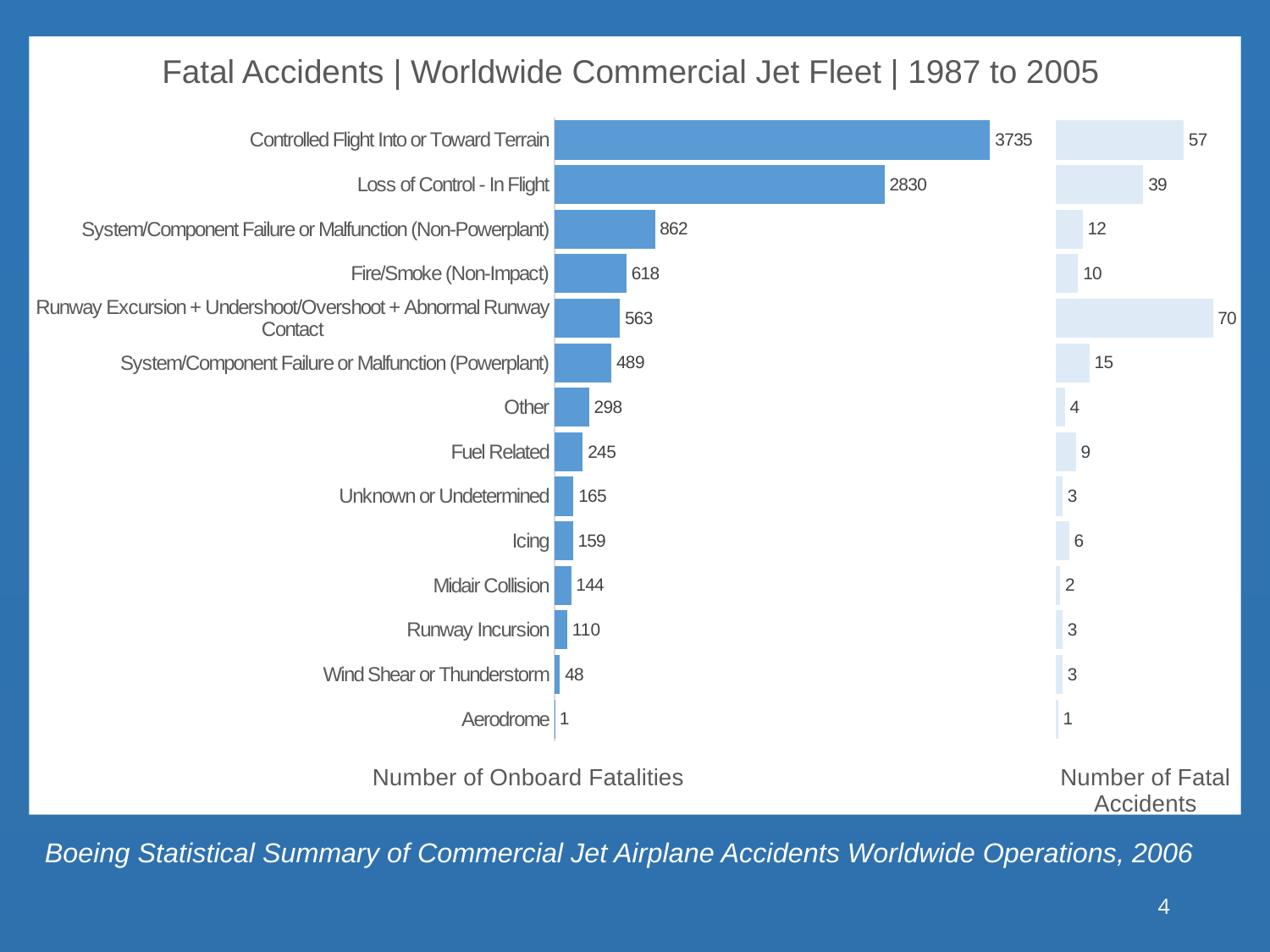
In the Number of Fatal Accidents chart, what is the difference between Controlled Flight Into or Toward Terrain and Loss of Control - In Flight? 18 How many categories are shown in the Number of Onboard Fatalities chart? 14 What type of chart is used for Number of Onboard Fatalities? Bar chart In the Number of Onboard Fatalities chart, which category has the highest value? Controlled Flight Into or Toward Terrain What is the title of the slide containing the charts? Fatal Accidents | Worldwide Commercial Jet Fleet | 1987 to 2005 In the Number of Fatal Accidents chart, which category has the highest value? Runway Excursion + Undershoot/Overshoot + Abnormal Runway Contact In the Number of Onboard Fatalities chart, which category has the lowest value? Aerodrome In the Number of Fatal Accidents chart, which is larger: Fuel Related or Icing? Fuel Related In the Number of Fatal Accidents chart, what is the value for Runway Excursion + Undershoot/Overshoot + Abnormal Runway Contact? 70 In the Number of Onboard Fatalities chart, what is the difference between Controlled Flight Into or Toward Terrain and Loss of Control - In Flight? 905 In the Number of Onboard Fatalities chart, which is larger: Fire/Smoke (Non-Impact) or System/Component Failure or Malfunction (Powerplant)? Fire/Smoke (Non-Impact) In the Number of Onboard Fatalities chart, what is the value for Loss of Control - In Flight? 2830